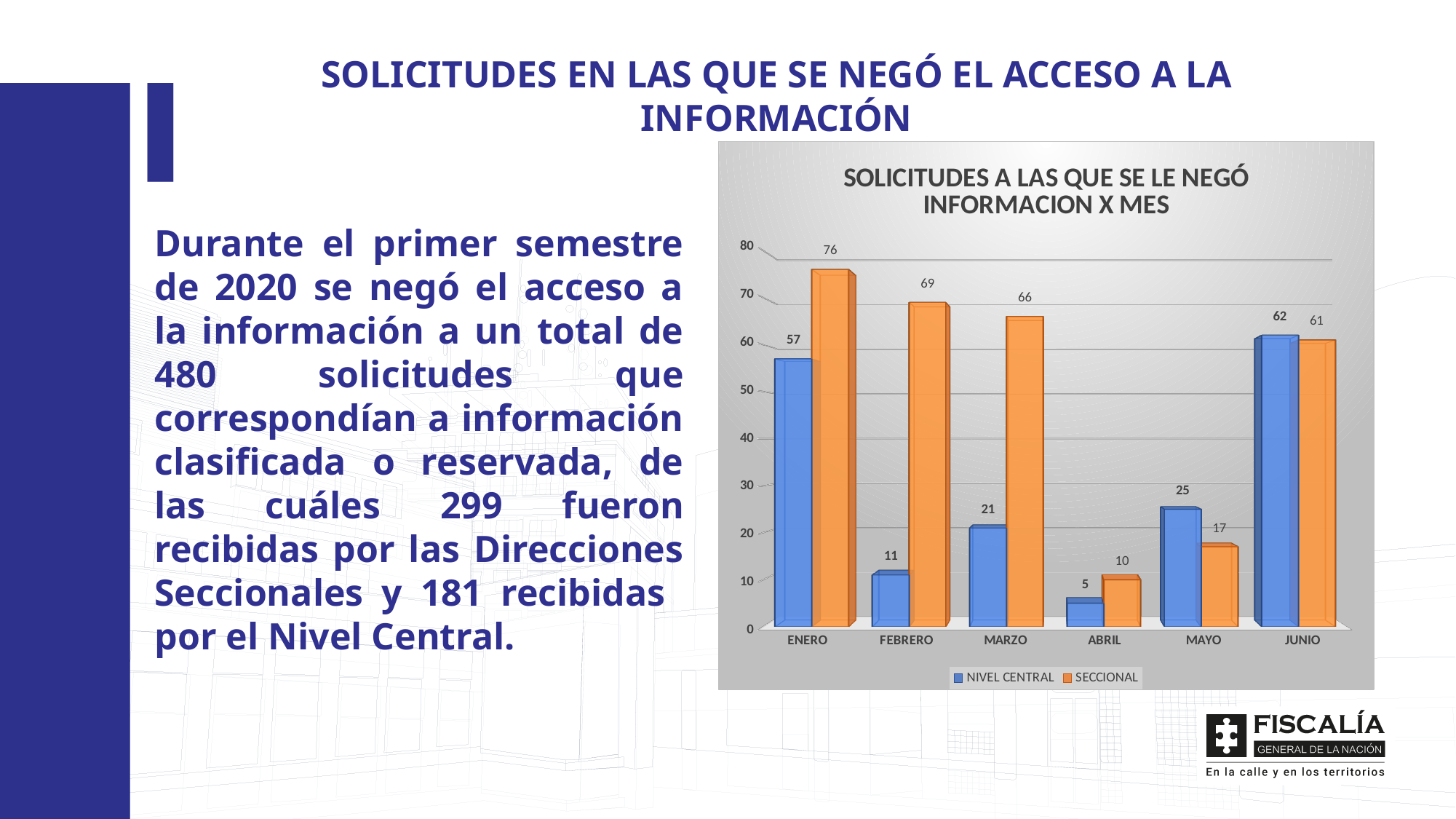
What is the title of the chart? SOLICITUDES A LAS QUE SE LE NEGÓ INFORMACION X MES How many months are shown on the x axis? 6 What is the value for SECCIONAL in MARZO? 66 How many series does the legend list? 2 Which month has the lowest NIVEL CENTRAL value? ABRIL In MAYO, which series has the larger value, NIVEL CENTRAL or SECCIONAL? NIVEL CENTRAL What is the value for NIVEL CENTRAL in ABRIL? 5 Is the SECCIONAL value for JUNIO greater or less than 50? greater What is the value for NIVEL CENTRAL in ENERO? 57 What kind of chart is shown on the slide? bar chart Which month has the highest SECCIONAL value? ENERO What is the difference between the SECCIONAL and NIVEL CENTRAL values in FEBRERO? 58